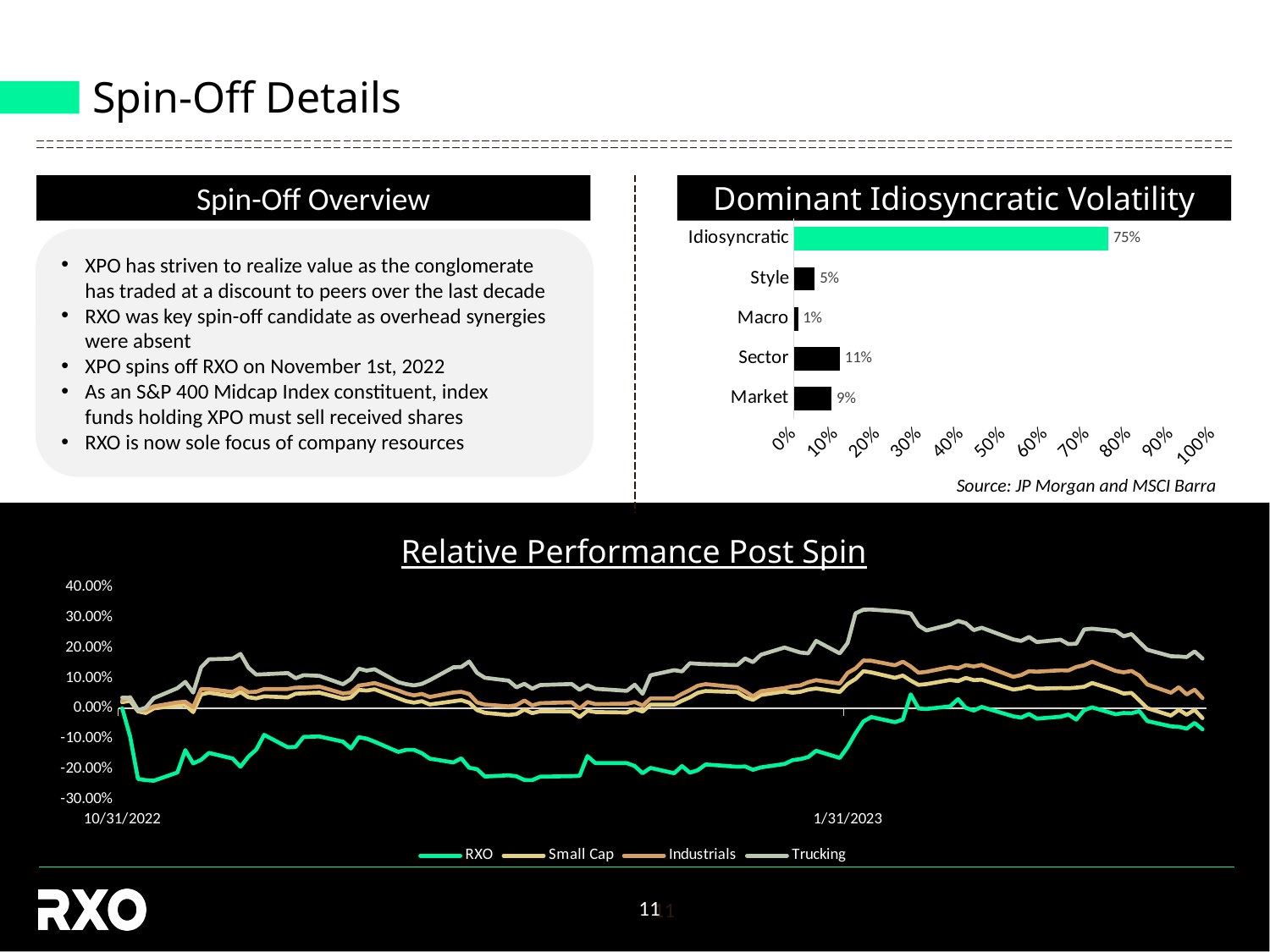
In the Dominant Idiosyncratic Volatility chart, what is the value for Sector? 11% In the Dominant Idiosyncratic Volatility chart, which category has the lowest value? Macro What kind of chart is the Dominant Idiosyncratic Volatility chart? Bar chart How many series does the legend of the Relative Performance Post Spin chart list? 4 In the Dominant Idiosyncratic Volatility chart, what is the value for Market? 9% How many categories are shown in the Dominant Idiosyncratic Volatility chart? 5 In the Dominant Idiosyncratic Volatility chart, what is the value for Idiosyncratic? 75% In the Relative Performance Post Spin chart, which series is plotted in green? RXO In the Dominant Idiosyncratic Volatility chart, which is larger, Style or Market? Market In the Dominant Idiosyncratic Volatility chart, which category has the highest value? Idiosyncratic What kind of chart is the Relative Performance Post Spin chart? Line chart In the Dominant Idiosyncratic Volatility chart, what is the difference between the Idiosyncratic and Sector values? 64%